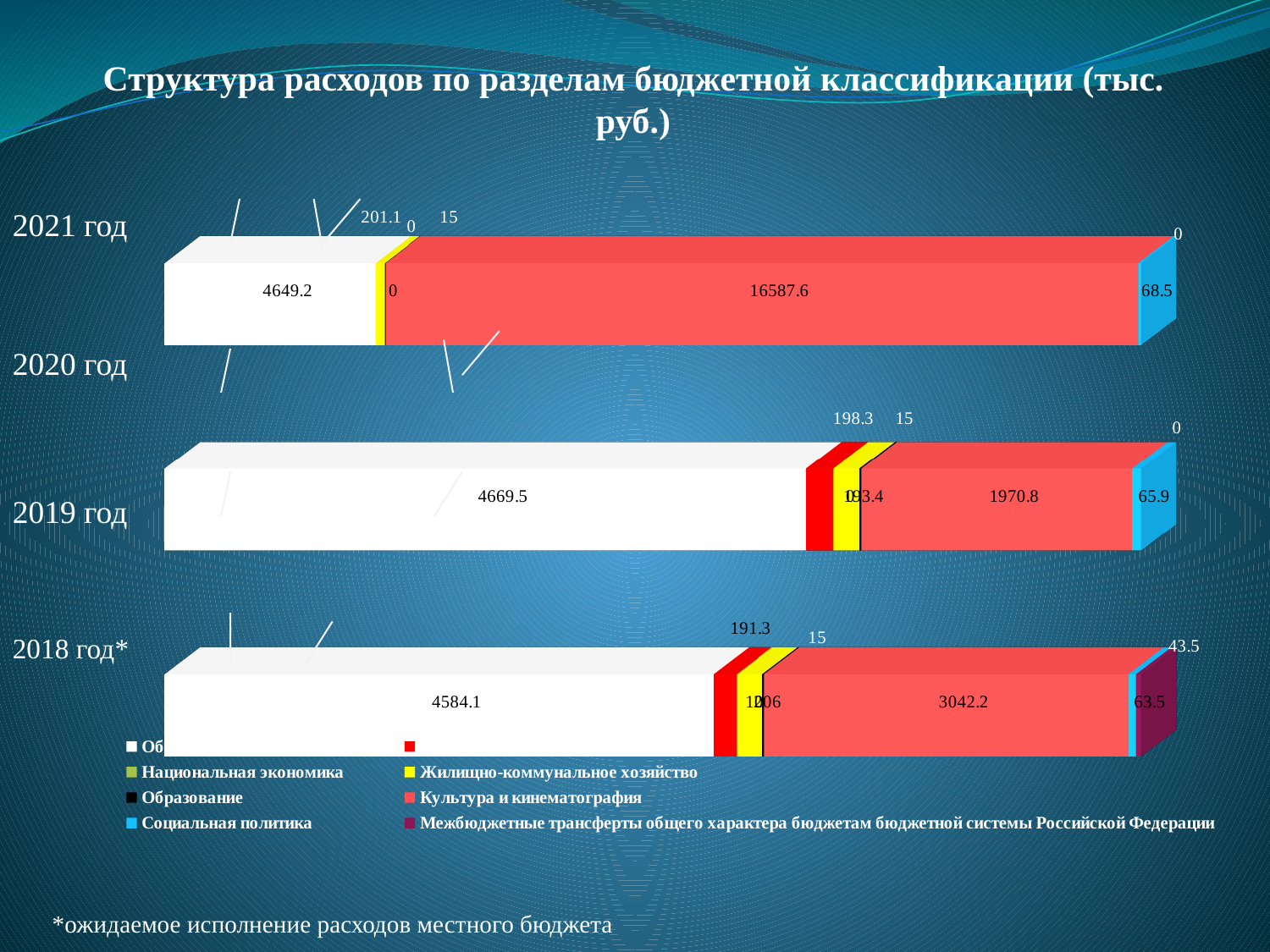
What kind of chart is shown on the slide? Stacked bar chart What is the value of the white segment in the bottom bar? 4584.1 What is the value of the purple 'Межбюджетные трансферты' segment in the bottom bar? 43.5 What is the value of the white segment in the top bar? 4649.2 What is the difference between the white segment of the middle bar (4669.5) and the white segment of the top bar (4649.2)? 20.3 What is the value of the blue 'Социальная политика' segment in the top bar? 68.5 What is the title of the chart? Структура расходов по разделам бюджетной классификации (тыс. руб.) What is the value of the 'Культура и кинематография' segment in the bottom bar? 3042.2 Which bar has the largest 'Культура и кинематография' segment: the top, middle or bottom bar? Top bar What is the value of the white segment in the middle bar? 4669.5 How many bars are plotted in the chart? 3 What is the value of the red 'Культура и кинематография' segment in the top bar? 16587.6